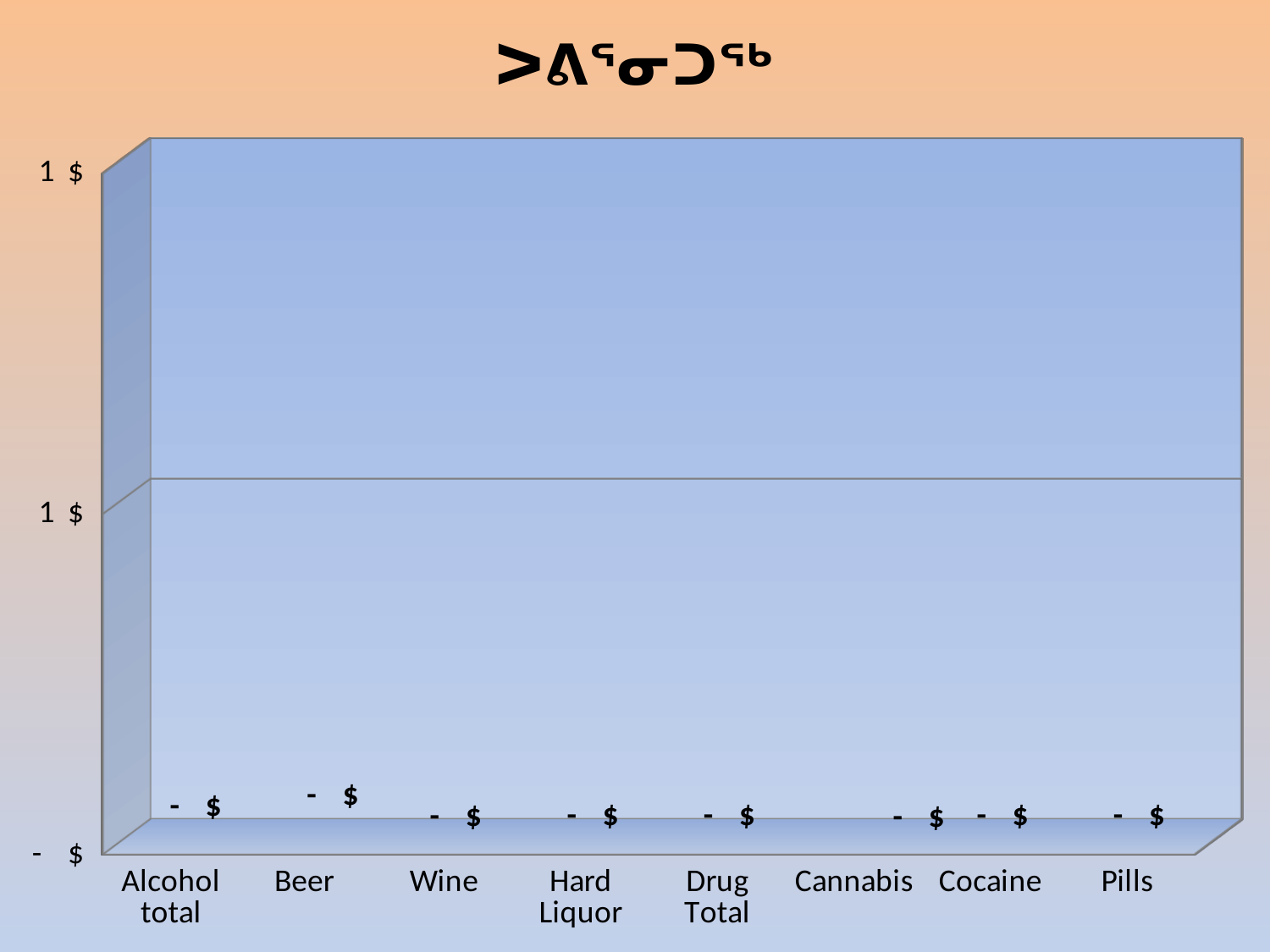
What value is labelled for Alcohol total? - $ Do the values rise, fall, or stay flat across the categories from left to right? stay flat How many categories are shown on the x axis of the chart? 8 Which category is listed last on the x axis? Pills What value is labelled for Cannabis? - $ Which category is listed first on the x axis? Alcohol total Is the value for Wine greater or less than 1 $? less What value is labelled for Drug Total? - $ Is the value for Cocaine greater or less than 1 $? less What value is labelled for Beer? - $ What kind of chart is shown on the slide? bar chart What value is labelled for Pills? - $